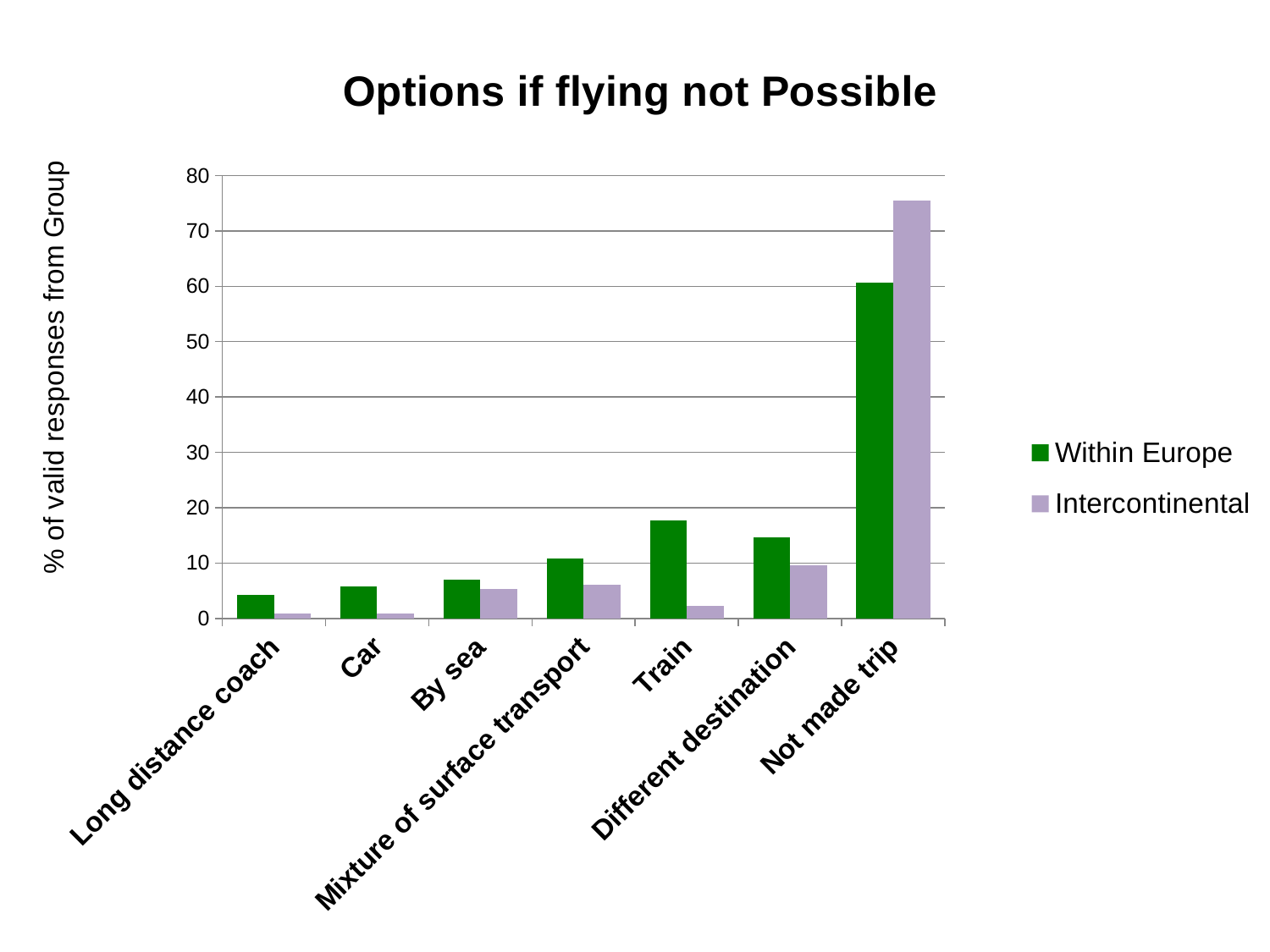
What type of chart is shown on the slide? bar chart How many series does the legend list? 2 Which category has the highest value for the Intercontinental series? Not made trip What is the title of the chart? Options if flying not Possible For Train, which series has the larger value, Within Europe or Intercontinental? Within Europe Which category has the highest value for the Within Europe series? Not made trip Is the Within Europe value for Train greater or less than 10? greater For Not made trip, which series has the larger value, Within Europe or Intercontinental? Intercontinental Is the Intercontinental value for Not made trip greater or less than 70? greater Is the Within Europe value for Not made trip greater or less than 70? less What is the label of the y axis? % of valid responses from Group How many categories are shown on the x axis? 7